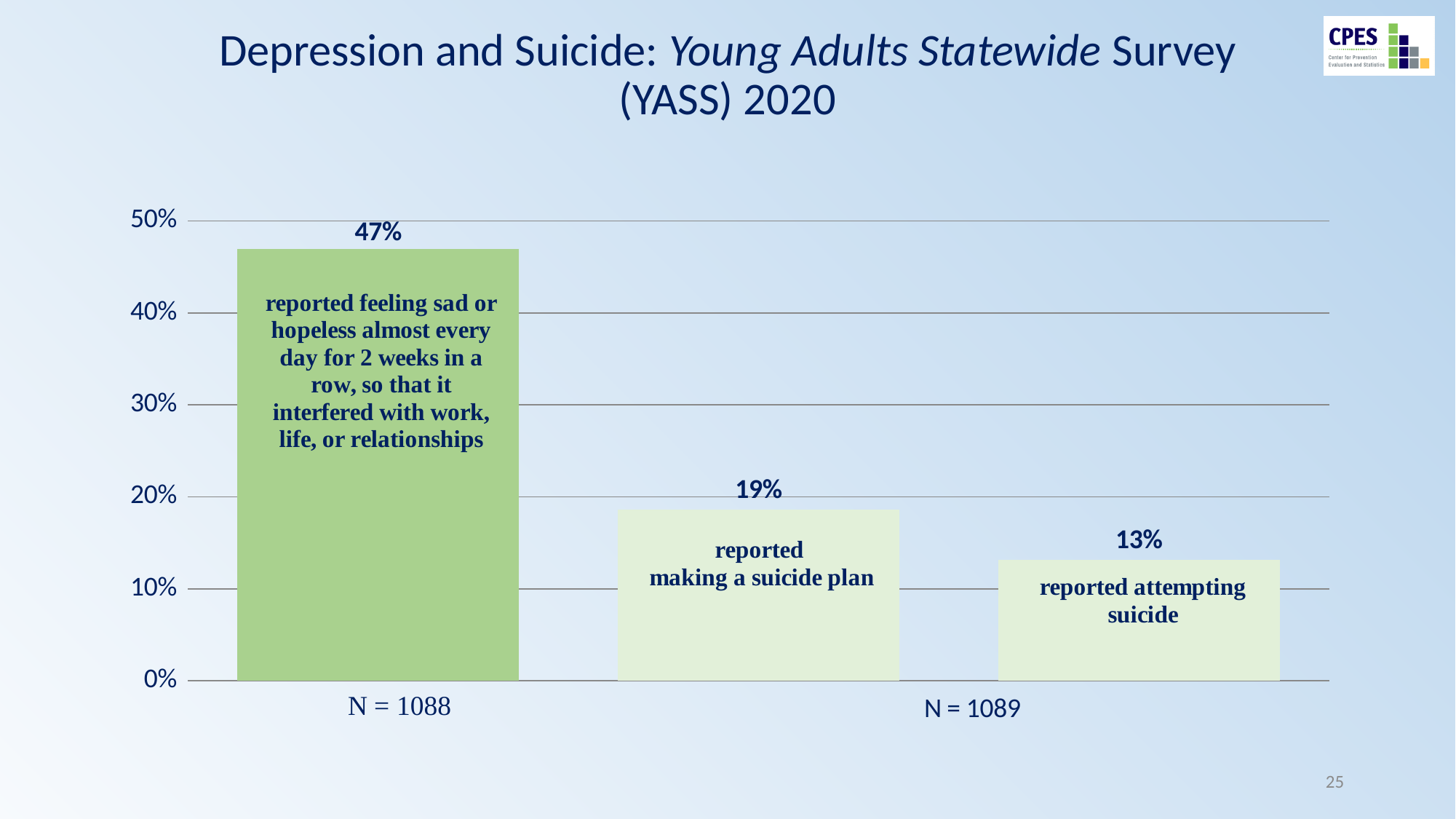
What percentage of young adults reported feeling sad or hopeless almost every day for 2 weeks in a row? 47% Which bar has the lowest value? reported attempting suicide Which bar has the highest value? reported feeling sad or hopeless almost every day for 2 weeks in a row Which is larger: the percentage who reported making a suicide plan or the percentage who reported attempting suicide? reported making a suicide plan What percentage reported attempting suicide? 13% What percentage reported making a suicide plan? 19% What kind of chart is shown on the slide? bar chart How many bars are shown in the chart? 3 What is the sample size (N) shown under the first bar? N = 1088 Is the value for reported feeling sad or hopeless greater or less than 40%? greater What is the difference between the percentage who reported making a suicide plan and the percentage who reported attempting suicide? 6% What is the difference between the percentage who reported feeling sad or hopeless and the percentage who reported making a suicide plan? 28%